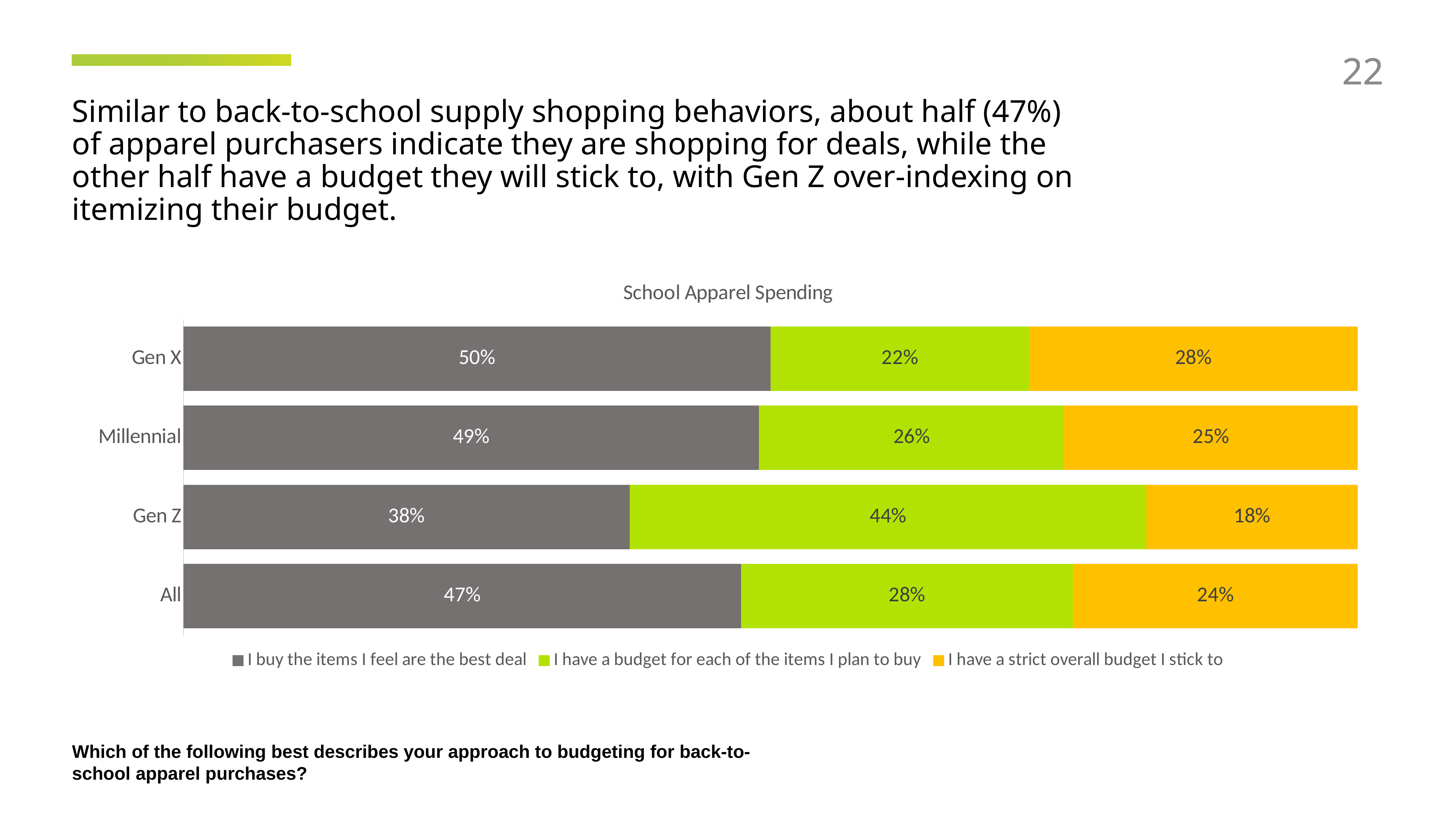
Which is larger: the 'I buy the items I feel are the best deal' share for Gen X or for Gen Z? Gen X What percentage of Gen Z respondents say 'I have a budget for each of the items I plan to buy'? 44% How many series does the legend list? 3 What kind of chart is shown on the slide? Stacked bar chart What is the total of the Gen X bar? 100% What percentage of Millennial respondents say 'I have a strict overall budget I stick to'? 25% What is the difference between Gen Z and All for 'I have a budget for each of the items I plan to buy'? 16 percentage points What percentage of Gen X respondents say 'I buy the items I feel are the best deal'? 50% Which group has the highest share for 'I have a budget for each of the items I plan to buy'? Gen Z How many groups are shown on the chart? 4 What is the title of the chart? School Apparel Spending Which group has the lowest share for 'I have a strict overall budget I stick to'? Gen Z